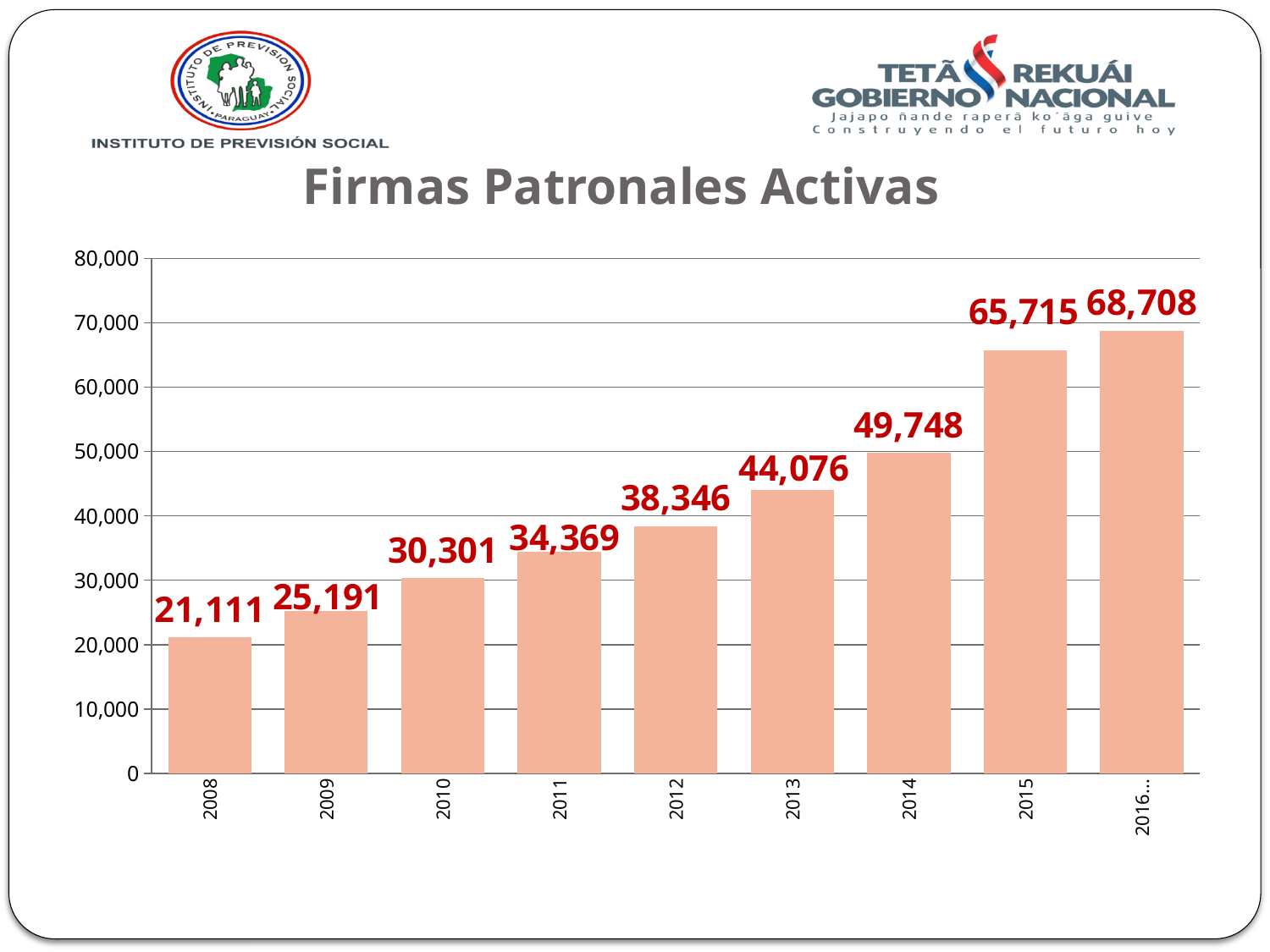
Which year has the lowest value? 2008 What is the value for 2012? 38,346 Do the values rise or fall from 2008 to 2016? rise How many years are shown on the x axis? 9 What is the value for 2008? 21,111 What is the difference between the values for 2016 and 2015? 2,993 Is the value for 2013 greater or less than 40,000? greater What is the difference between the values for 2014 and 2013? 5,672 Which year has the highest value? 2016 Which is larger, the value for 2010 or the value for 2011? 2011 What is the value for 2015? 65,715 What kind of chart is this? bar chart